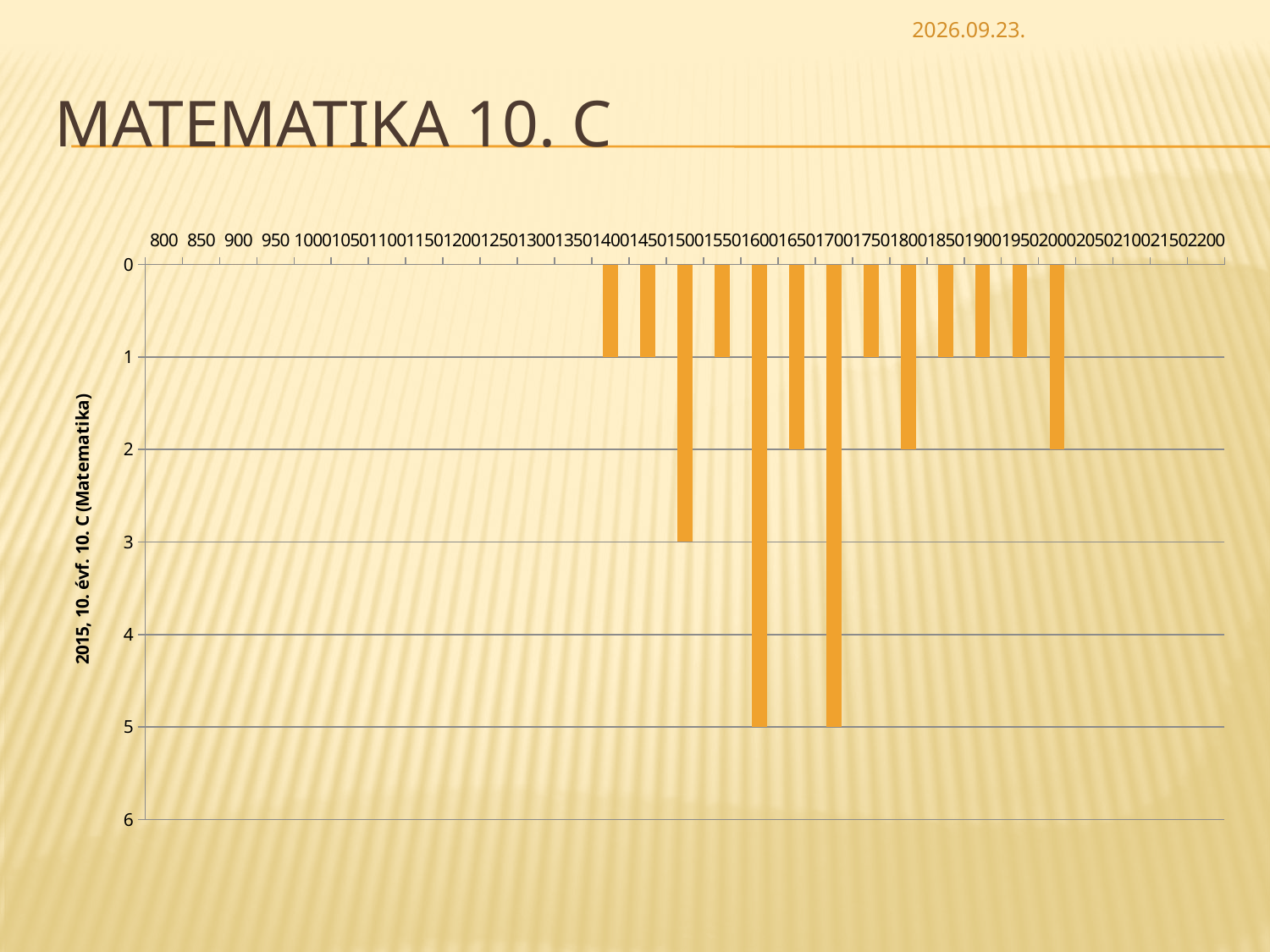
What is the value for the 1400 category? 1 What kind of chart is shown on the slide? bar chart What is the value for the 1600 category? 5 What is the difference between the value for 1600 and the value for 1650? 3 What is the title of the slide containing the chart? MATEMATIKA 10. C What is the value for the 1650 category? 2 How many categories have a bar plotted in the chart? 13 What is the difference between the value for 1500 and the value for 1550? 2 Which is larger, the value for 1800 or the value for 1700? 1700 What is the value for the 1500 category? 3 What is the value for the 2000 category? 2 Which is larger, the value for 1500 or the value for 1650? 1500